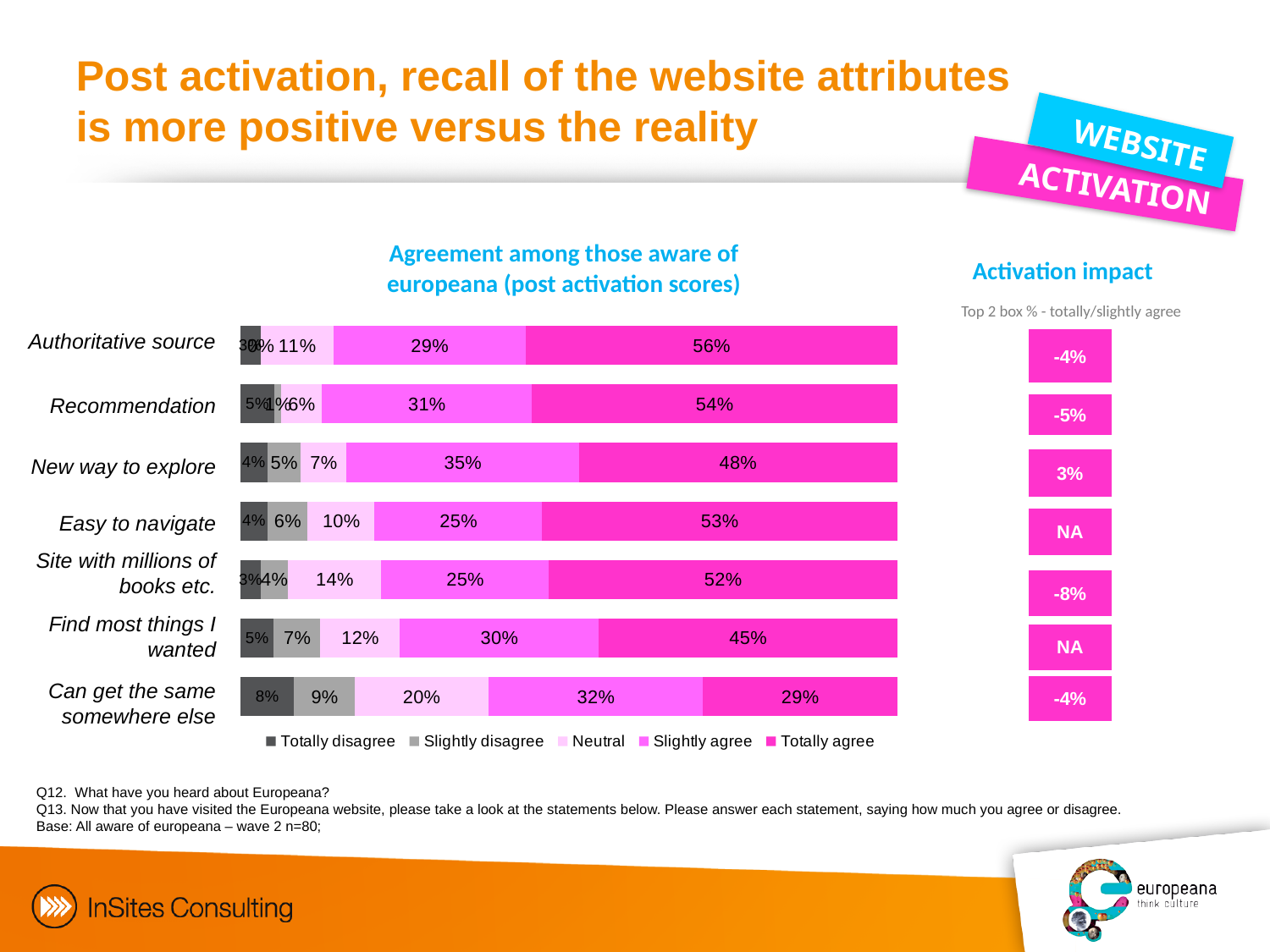
Which statement has the highest 'Totally agree' percentage? Authoritative source What is the 'Totally disagree' value for 'Can get the same somewhere else'? 8% What is the combined 'Slightly agree' and 'Totally agree' percentage for 'New way to explore'? 83% What type of chart is used to show the agreement scores? Stacked bar chart What is the 'Neutral' value for 'Can get the same somewhere else'? 20% How many statements are shown in the chart? 7 How many series does the legend list? 5 Which has a larger 'Slightly agree' value: 'New way to explore' or 'Can get the same somewhere else'? New way to explore What is the 'Slightly agree' value for 'New way to explore'? 35% What percentage of respondents totally agree that Europeana is an authoritative source? 56% Which statement has the lowest 'Totally agree' percentage? Can get the same somewhere else What is the difference in 'Totally agree' percentage between 'Easy to navigate' and 'Find most things I wanted'? 8 percentage points